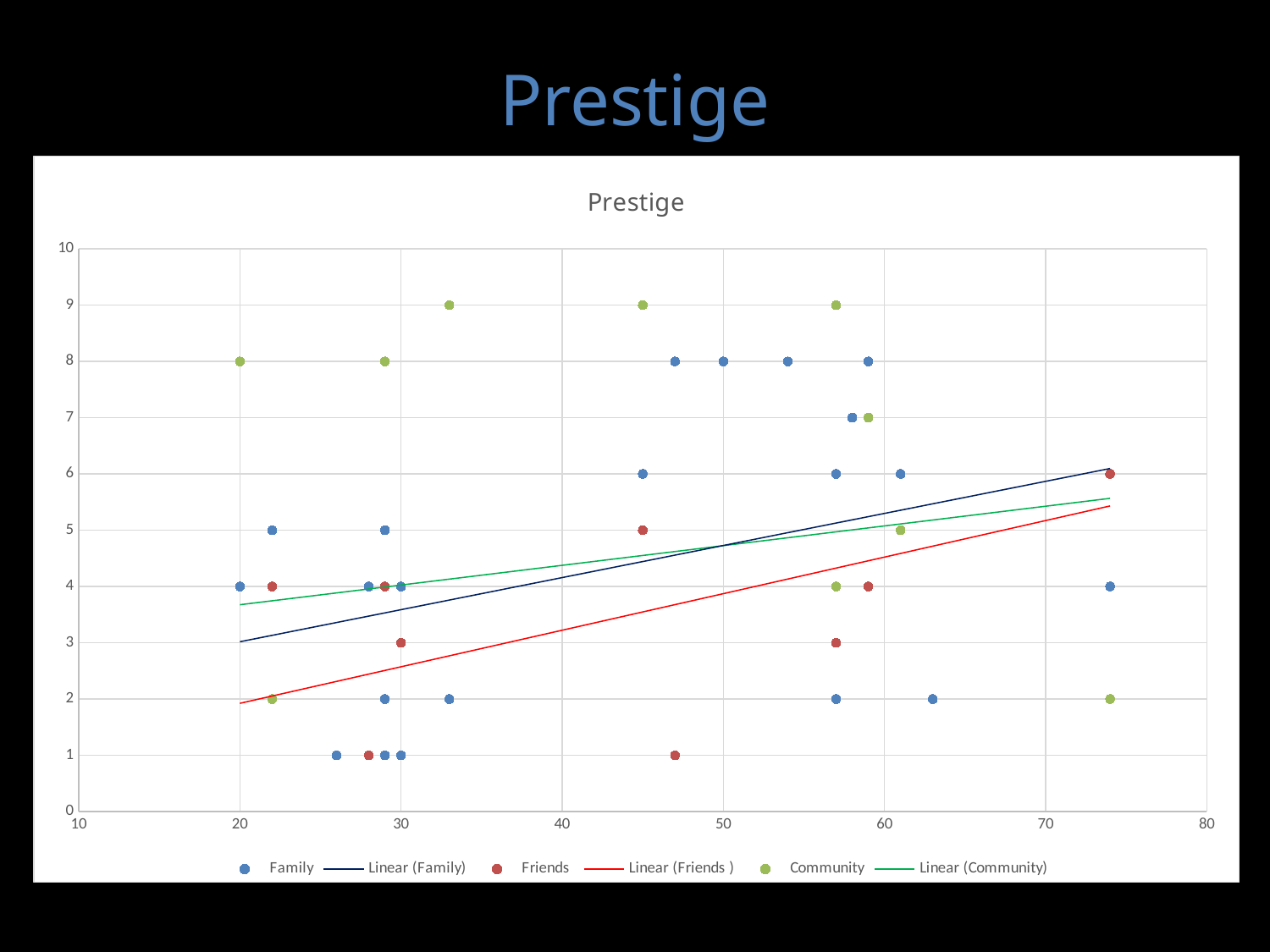
What kind of chart is shown on the slide? Scatter chart Do the three linear trendlines rise or fall as the x value increases? Rise What is the highest y value reached by any Community point? 9 Which trendline is the highest at x = 20? Linear (Community) How many entries does the chart legend list? 6 What is the lowest y value reached by any Friends point? 1 What is the title of the chart? Prestige Is the value of the Linear (Friends ) trendline at x = 74 greater or less than 5? greater What colour are the Family data points? Blue What is the highest y value reached by any Family point? 8 Which trendline is the lowest at x = 20? Linear (Friends )